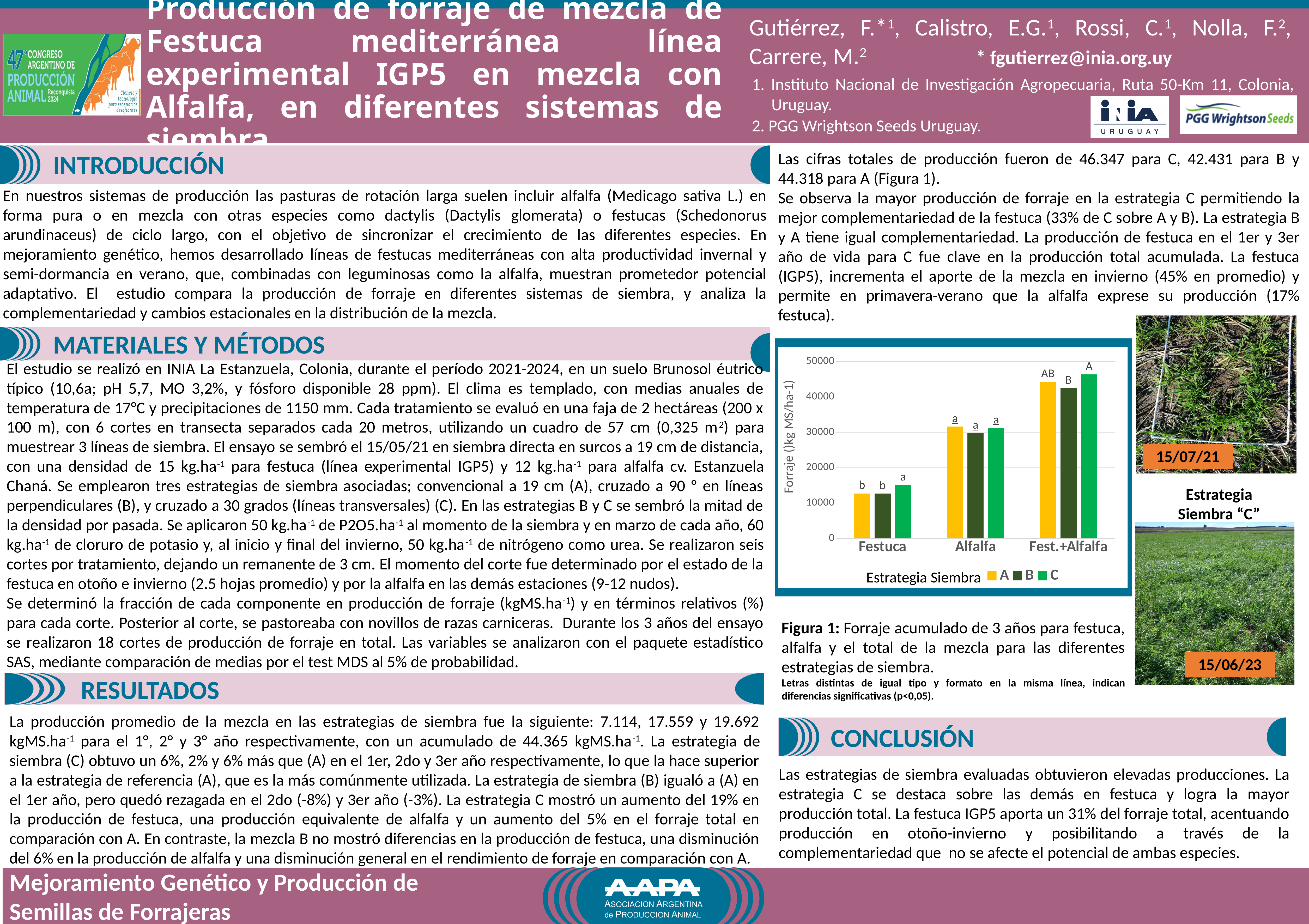
How many series does the chart legend list? 3 Is the value for series A in the Alfalfa category greater or less than 40000? less In the Festuca category, which is larger, series B or series C? C What are the legend entries of the chart? A, B, C What kind of chart is shown in Figura 1? bar chart Is the value for series C in the Festuca category greater or less than 20000? less How many categories are shown on the x axis of the chart? 3 Is the value for series C in the Fest.+Alfalfa category greater or less than 40000? greater In the Fest.+Alfalfa category, which series has the highest bar? C What is the x-axis title of the chart? Estrategia Siembra Which category has the lowest values across all series? Festuca